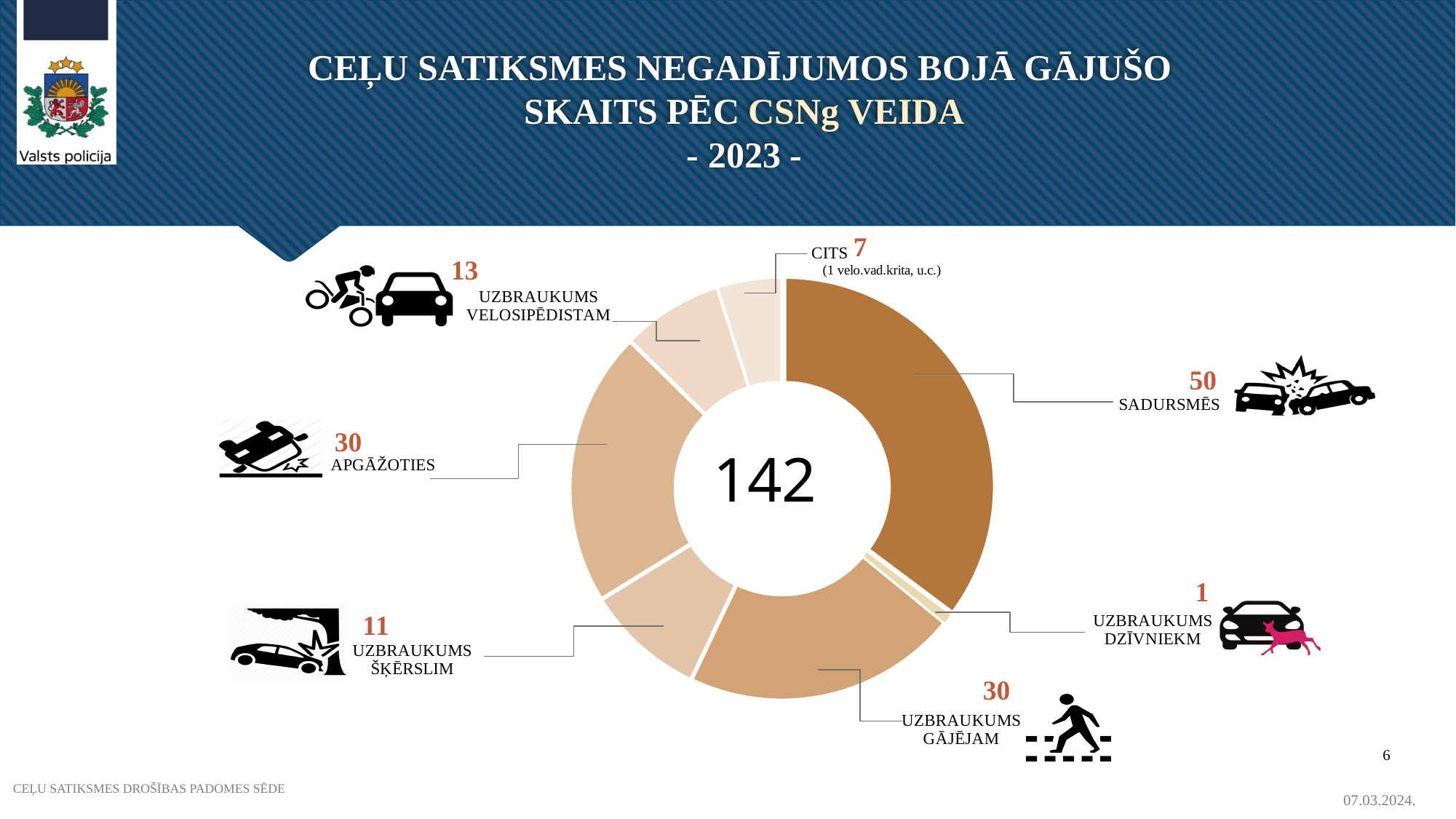
What is the value for UZBRAUKUMS ŠĶĒRSLIM? 11 What is the value for UZBRAUKUMS VELOSIPĒDISTAM? 13 What is the value for CITS? 7 What year is given in the chart title? 2023 What kind of chart is shown on the slide? Pie (donut) chart What total is shown in the centre of the chart? 142 Which is larger, the value for UZBRAUKUMS VELOSIPĒDISTAM or the value for UZBRAUKUMS ŠĶĒRSLIM? UZBRAUKUMS VELOSIPĒDISTAM Which category has the highest value? SADURSMĒS What is the value for SADURSMĒS? 50 Which category has the lowest value? UZBRAUKUMS DZĪVNIEKM How many categories does the chart show? 7 What is the difference between the values for SADURSMĒS and APGĀŽOTIES? 20